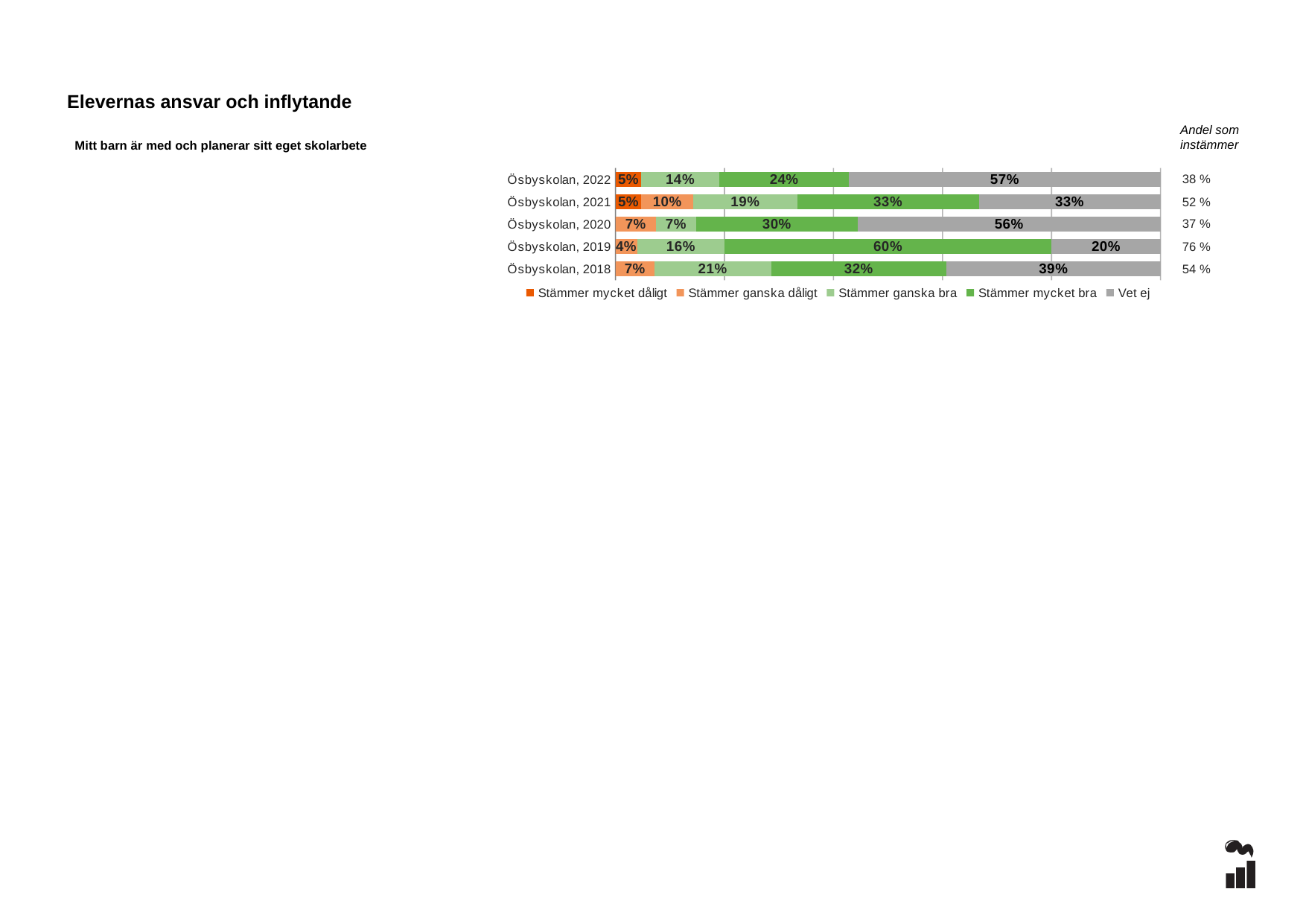
How many series does the legend list? 5 Which is larger: "Stämmer mycket bra" for Ösbyskolan, 2020 or for Ösbyskolan, 2018? Ösbyskolan, 2018 Which category has the highest value for "Stämmer mycket bra"? Ösbyskolan, 2019 What is the difference between the "Vet ej" values for Ösbyskolan, 2022 and Ösbyskolan, 2021? 24% What is the value of "Stämmer ganska dåligt" for Ösbyskolan, 2021? 10% What is the value of "Stämmer ganska bra" for Ösbyskolan, 2018? 21% What is the value of "Stämmer mycket bra" for Ösbyskolan, 2019? 60% Which category has the lowest value for "Vet ej"? Ösbyskolan, 2019 What is the value of "Vet ej" for Ösbyskolan, 2022? 57% How many categories (bars) are shown in the chart? 5 What kind of chart is shown on the slide? Stacked bar chart What is the "Andel som instämmer" value shown for Ösbyskolan, 2019? 76 %